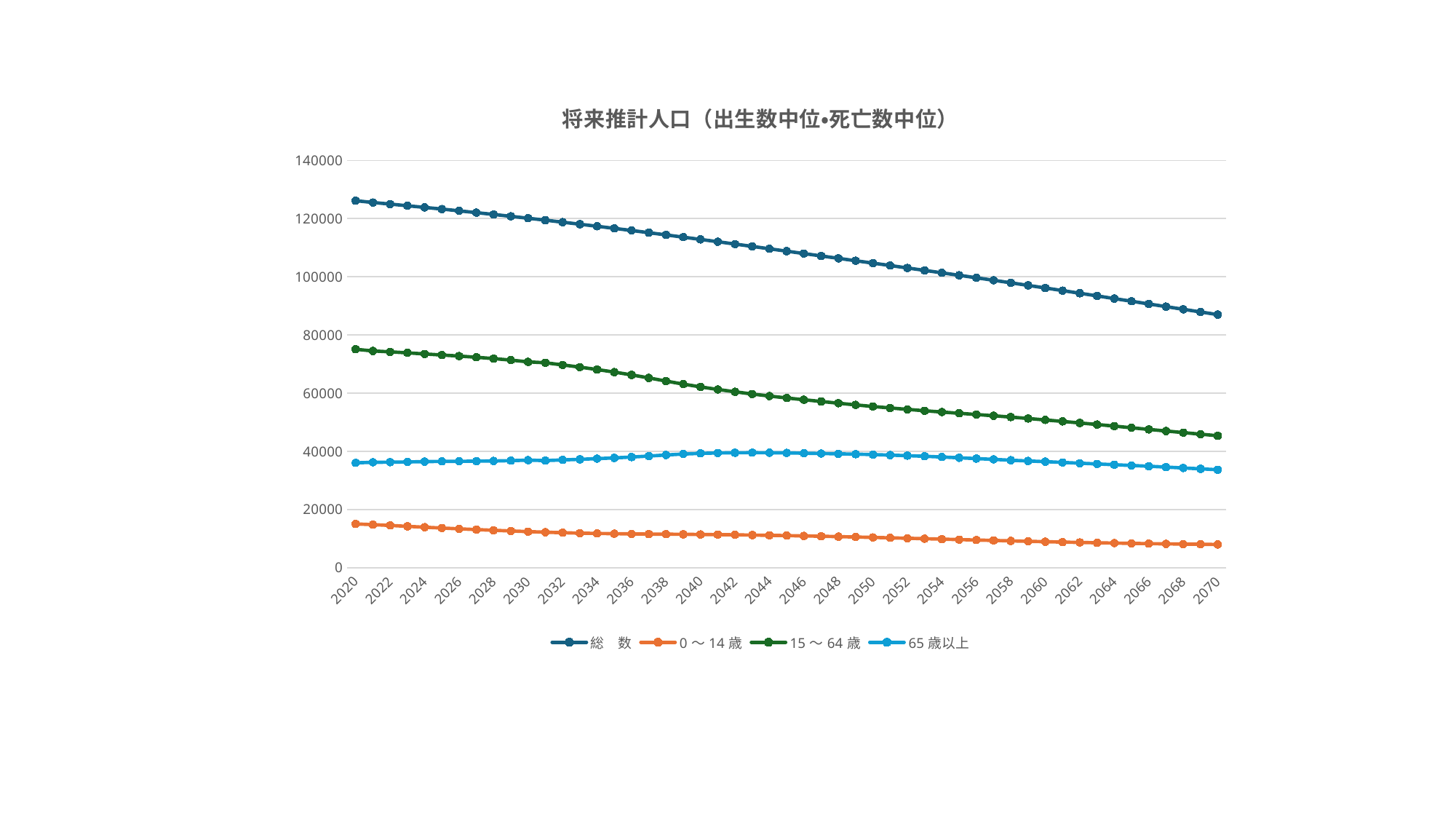
Is the value for 総数 in 2020 greater or less than 120000? greater What is the title of the chart? 将来推計人口（出生数中位•死亡数中位） Do the values for 総数 rise or fall from 2020 to 2070? fall Which series is plotted with the orange line? 0～14歳 What kind of chart is shown on the slide? line chart How many series does the legend list? 4 Is the value for 0～14歳 in 2020 greater or less than 20000? less Is the value for 15～64歳 in 2020 greater or less than 80000? less Do the values for 15～64歳 rise or fall from 2020 to 2070? fall Which series has the lowest value in 2070? 0～14歳 In 2070, which is larger: the value for 65歳以上 or the value for 0～14歳? 65歳以上